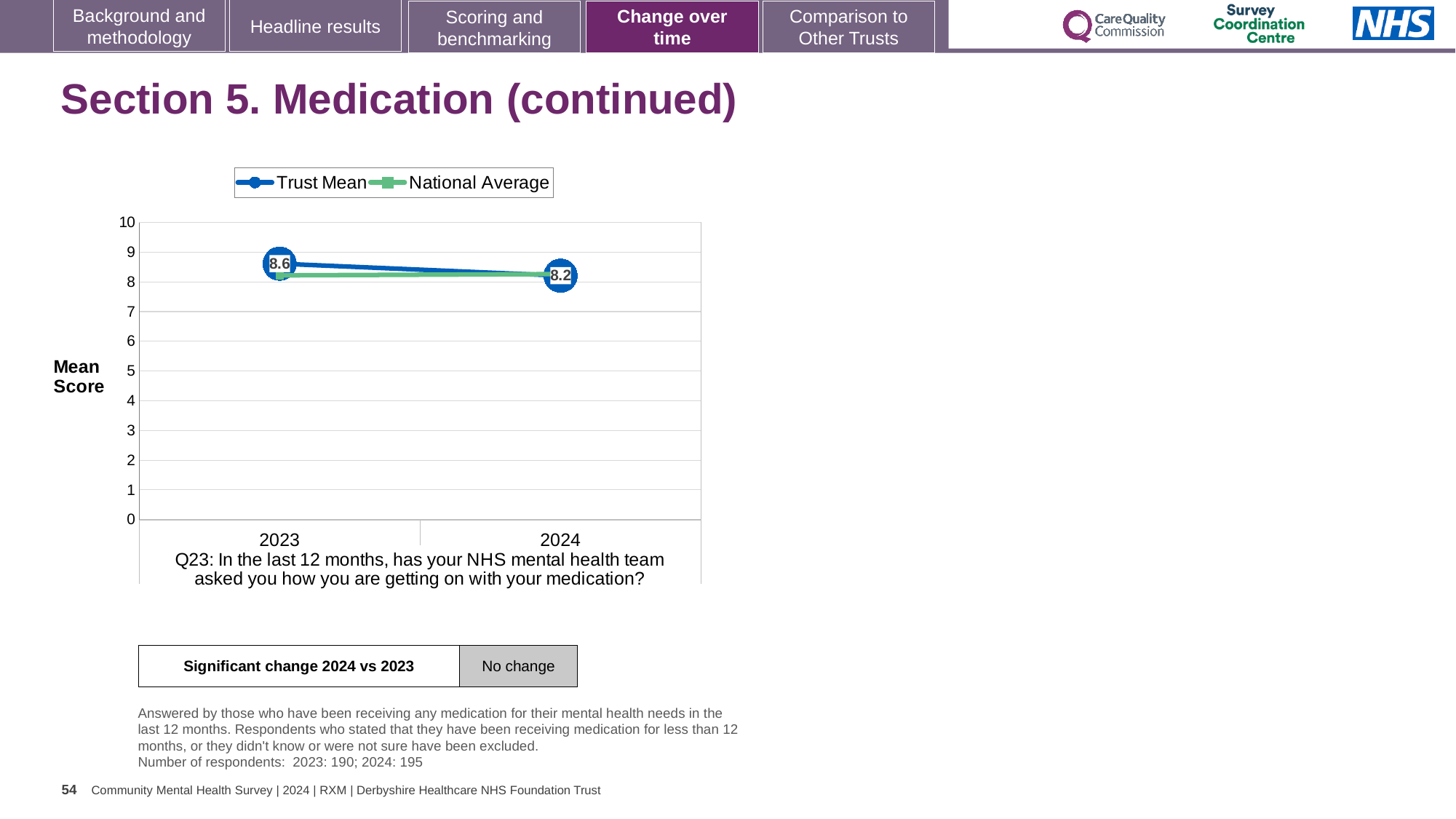
What is the Trust Mean value for 2024? 8.2 How many years are plotted on the x axis? 2 What is the label on the y axis? Mean Score By how much did the Trust Mean change from 2023 to 2024? 0.4 What kind of chart is shown on the slide? line chart Is the National Average value for 2024 greater or less than 5? greater What are the two series named in the legend? Trust Mean and National Average In which year is the Trust Mean highest? 2023 Does the Trust Mean rise or fall from 2023 to 2024? fall What is the Trust Mean value for 2023? 8.6 How many series does the legend list? 2 Which is larger, the Trust Mean for 2023 or for 2024? 2023